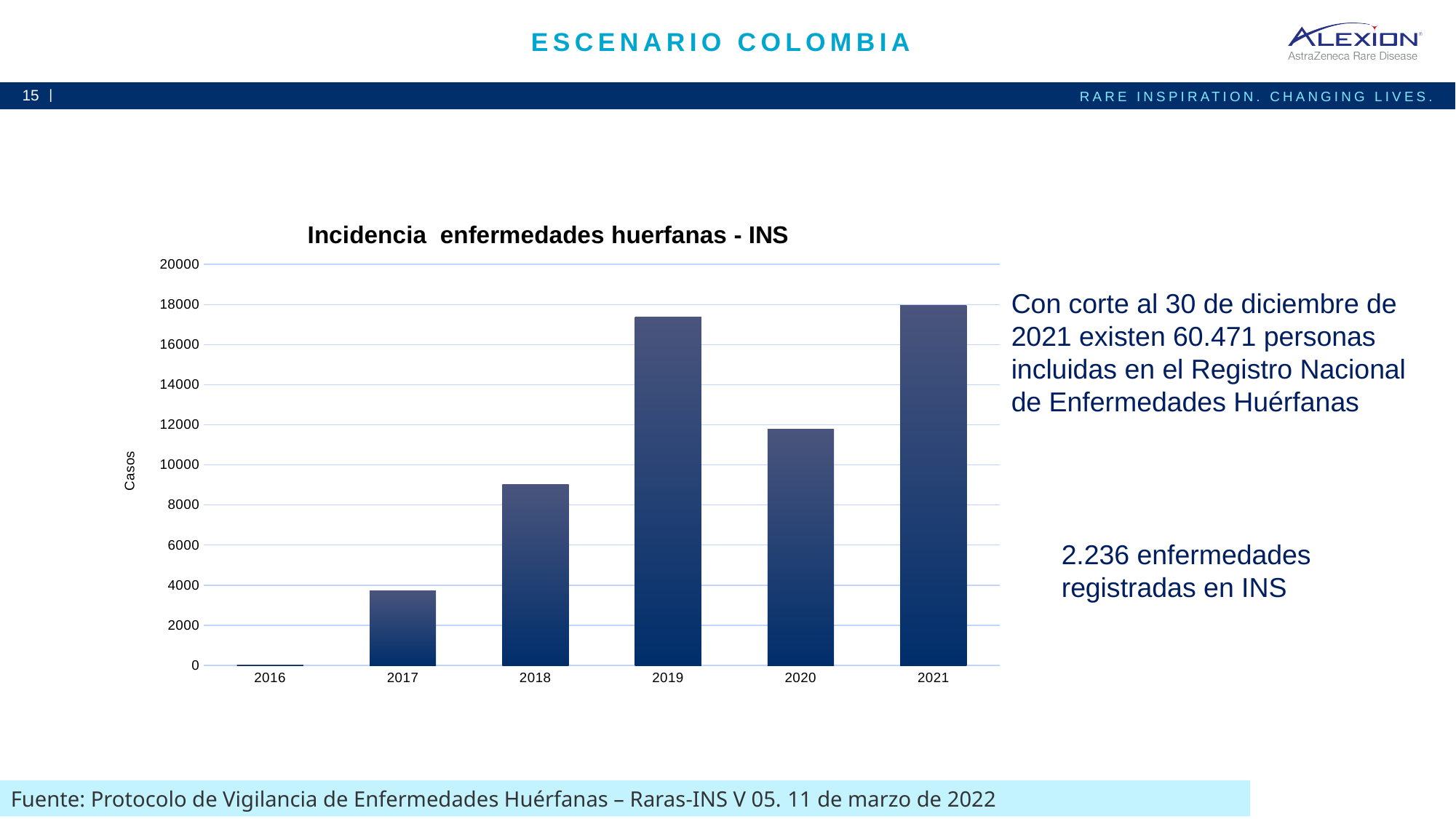
Which year has more cases, 2017 or 2018? 2018 Is the value for 2019 greater or less than 16000? greater How many years are shown on the x axis of the chart? 6 Is the value for 2016 greater or less than 2000? less What is the title of the chart? Incidencia enfermedades huerfanas - INS Which year has the lowest number of cases in the chart? 2016 Is the value for 2018 greater or less than 8000? greater Which year has more cases, 2019 or 2020? 2019 Does the number of cases rise or fall from 2019 to 2020? fall What kind of chart is shown on the slide? bar chart